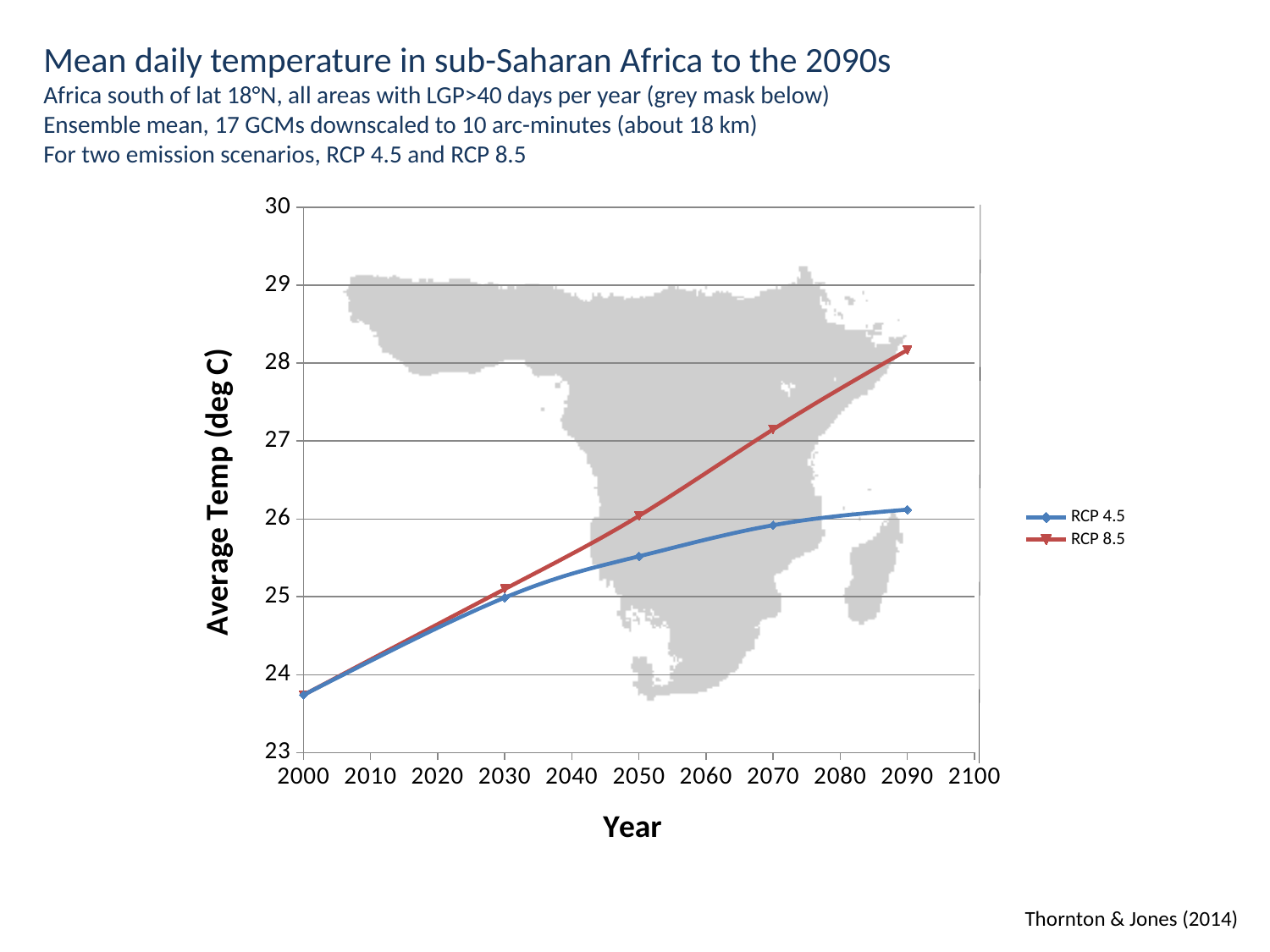
Is the value for RCP 8.5 in 2070 greater or less than 26? greater Is the value for RCP 4.5 in 2000 greater or less than 24? less What is the title of the y axis? Average Temp (deg C) What kind of chart is shown on the slide? line chart How many series does the legend list? 2 Do the values for RCP 4.5 rise or fall from 2000 to 2090? rise Do the values for RCP 8.5 rise or fall from 2000 to 2090? rise How many data points are plotted for the RCP 8.5 series? 5 Is the value for RCP 8.5 in 2090 greater or less than 27? greater In 2090, which series has the higher value, RCP 4.5 or RCP 8.5? RCP 8.5 What are the two series named in the legend? RCP 4.5 and RCP 8.5